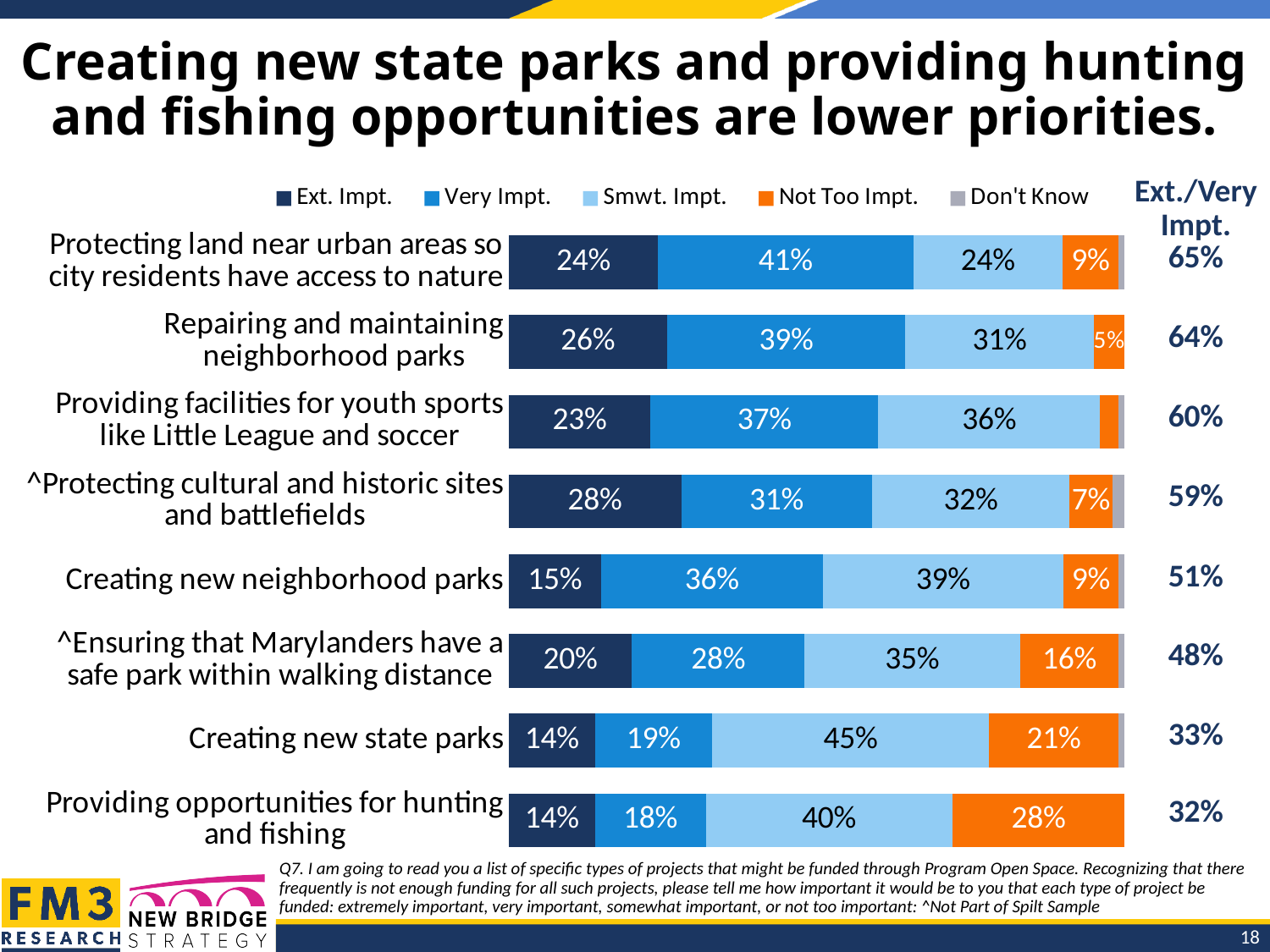
Which has a larger Smwt. Impt. value: 'Creating new state parks' or 'Providing opportunities for hunting and fishing'? Creating new state parks Which project has the highest combined Ext./Very Impt. percentage? Protecting land near urban areas so city residents have access to nature (65%) What is the difference in Ext./Very Impt. percentage between 'Creating new neighborhood parks' and 'Creating new state parks'? 18 percentage points What kind of chart is shown on the slide? Stacked bar chart How many series does the legend list? 5 What is the Not Too Impt. value for 'Providing opportunities for hunting and fishing'? 28% What is the Very Impt. value for 'Repairing and maintaining neighborhood parks'? 39% How many project categories are shown in the chart? 8 Which project has the highest Ext. Impt. value? Protecting cultural and historic sites and battlefields (28%) What percentage of respondents rated 'Protecting land near urban areas so city residents have access to nature' as Ext. Impt.? 24% Which project has the lowest combined Ext./Very Impt. percentage? Providing opportunities for hunting and fishing (32%) Which legend entry is shown in orange? Not Too Impt.